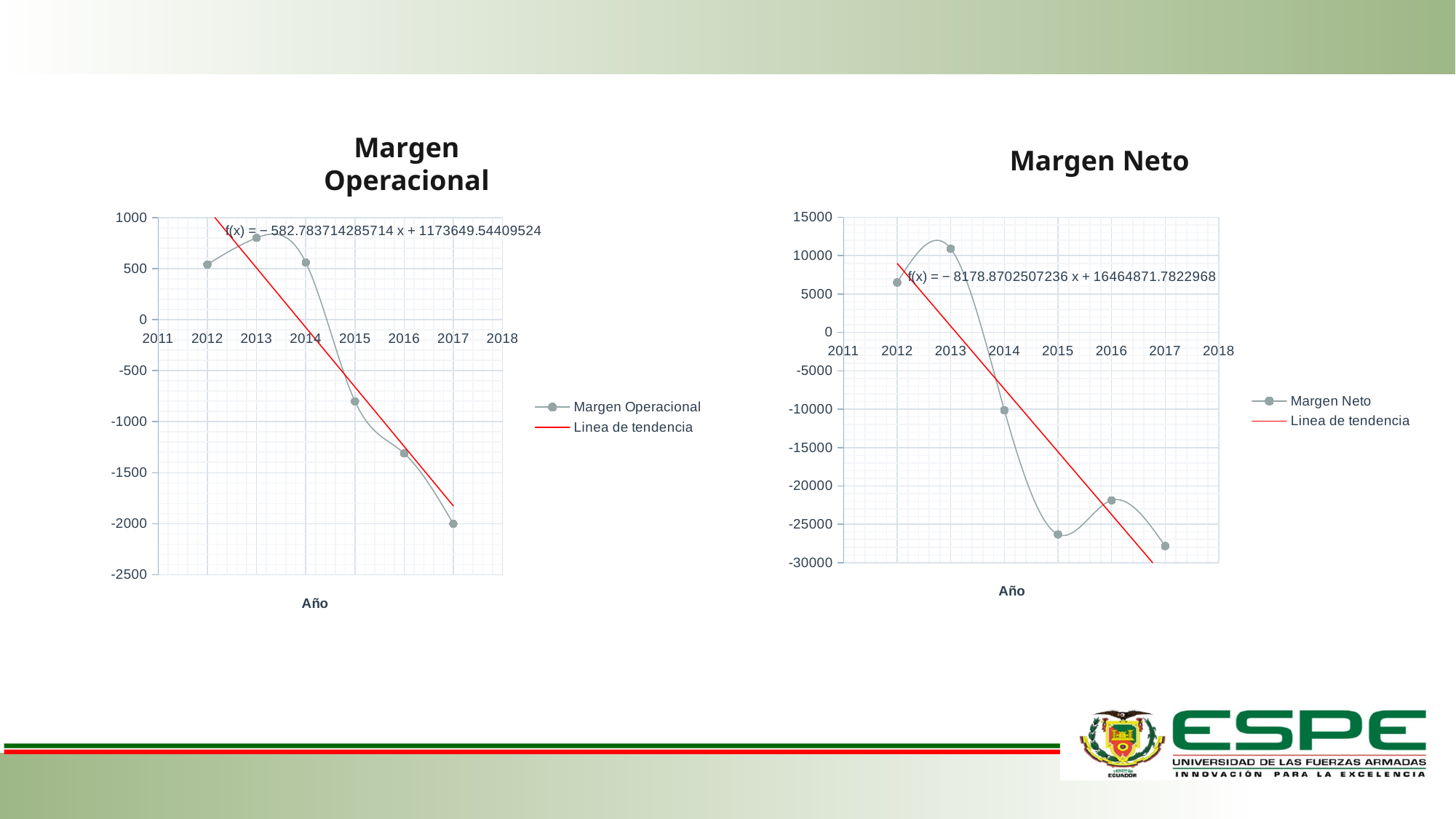
In the 'Margen Operacional' chart, which year has the lowest value? 2017 In the 'Margen Neto' chart, which year has the highest value? 2013 In the 'Margen Operacional' chart, is the value for 2015 greater or less than -500? less In the 'Margen Operacional' chart, is the value for 2013 greater or less than 500? greater In the 'Margen Neto' chart, do the values generally rise or fall from 2013 to 2017? fall In the 'Margen Neto' chart, which is larger, the value for 2012 or the value for 2013? 2013 In the 'Margen Neto' chart, is the value for 2014 greater or less than -5000? less In the 'Margen Operacional' chart, which year has the highest value? 2013 What kind of chart is the 'Margen Operacional' chart? line chart What is the x-axis title of the 'Margen Neto' chart? Año How many series does the legend of the 'Margen Neto' chart list? 2 How many data points does the 'Margen Operacional' series have? 6